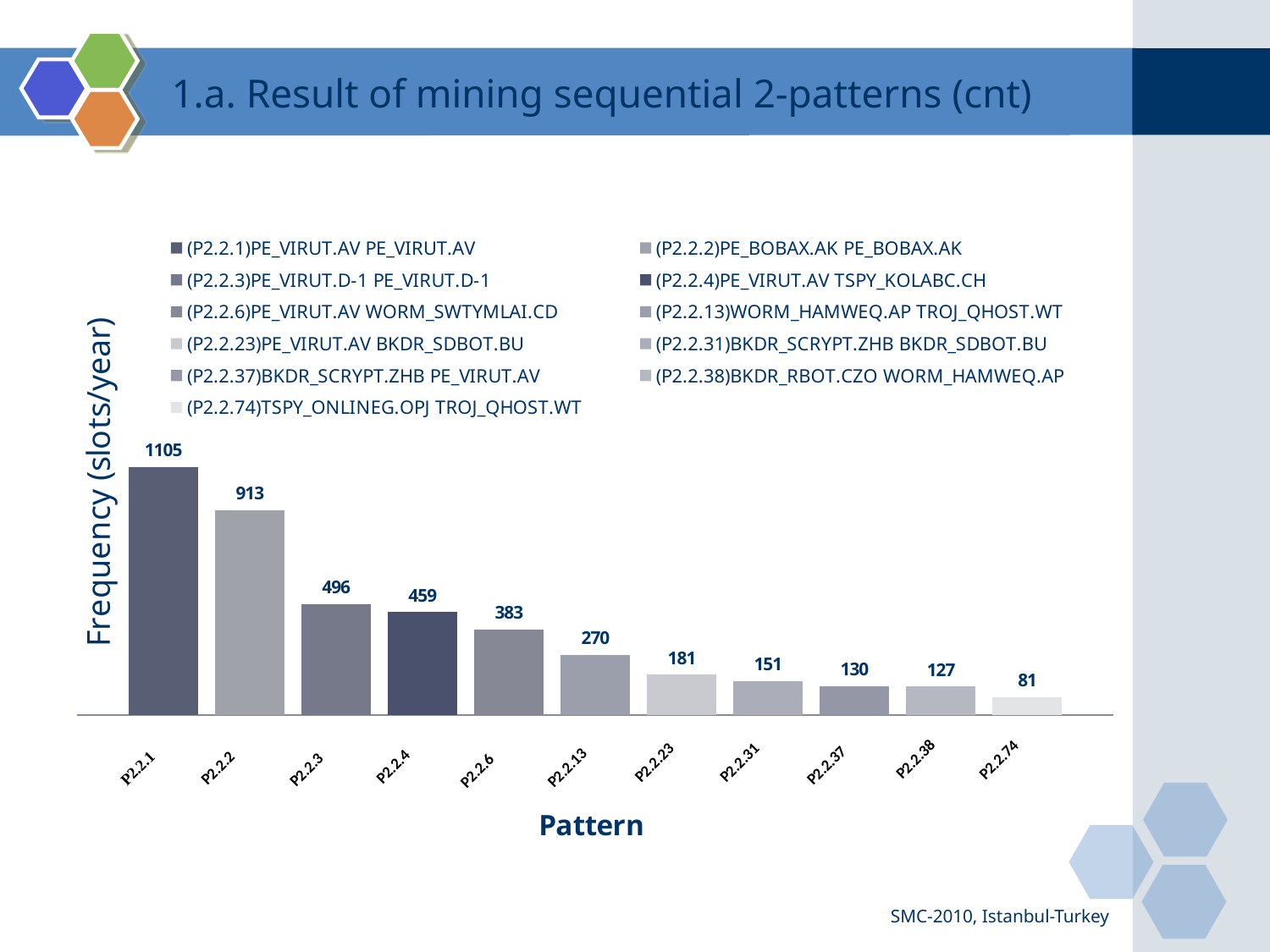
Which has a larger frequency, P2.2.6 or P2.2.23? P2.2.6 How many patterns (bars) are plotted in the chart? 11 What is the frequency value for pattern P2.2.1? 1105 What is the difference between the frequency values for P2.2.3 and P2.2.4? 37 What is the frequency value for pattern P2.2.38? 127 Which pattern has the highest frequency? P2.2.1 Which pattern has the lowest frequency? P2.2.74 How many entries does the legend list? 11 What is the difference between the frequency values for P2.2.1 and P2.2.2? 192 What is the frequency value for pattern P2.2.13? 270 What is the label of the vertical axis of the chart? Frequency (slots/year) What kind of chart is shown on the slide? Bar chart